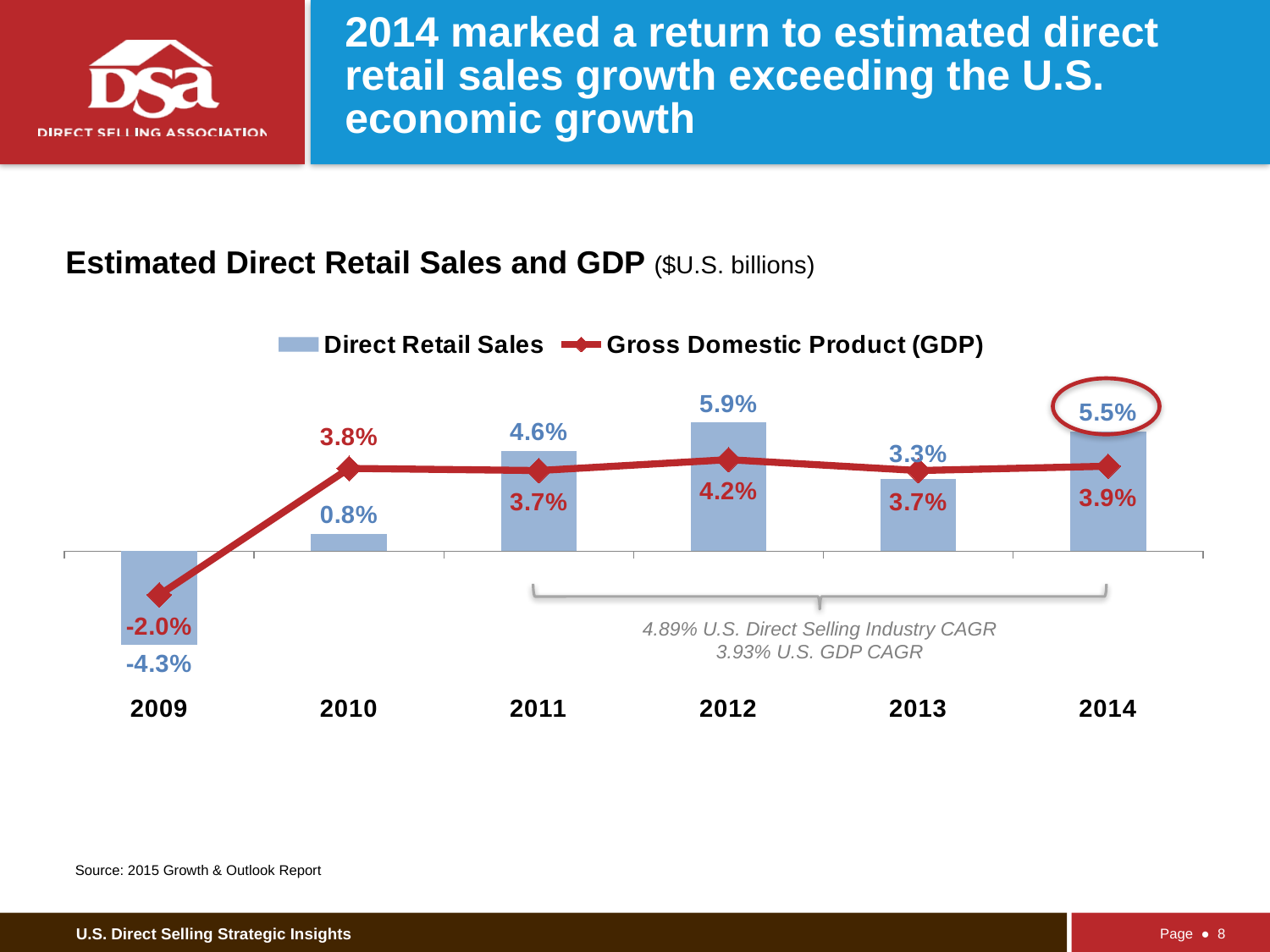
What is the Gross Domestic Product (GDP) value for 2010? 3.8% Which year has the lowest GDP growth? 2009 Which year has the highest Direct Retail Sales growth? 2012 What is the title of the chart? Estimated Direct Retail Sales and GDP ($U.S. billions) What kind of chart is used to show Direct Retail Sales? Bar chart What is the GDP value for 2014? 3.9% What is the difference between Direct Retail Sales and GDP growth in 2014? 1.6% What is the Direct Retail Sales value for 2012? 5.9% What is the Direct Retail Sales value for 2009? -4.3% How many years are shown on the x axis? 6 In 2013, which is larger: Direct Retail Sales growth or GDP growth? GDP growth How many series does the legend list? 2